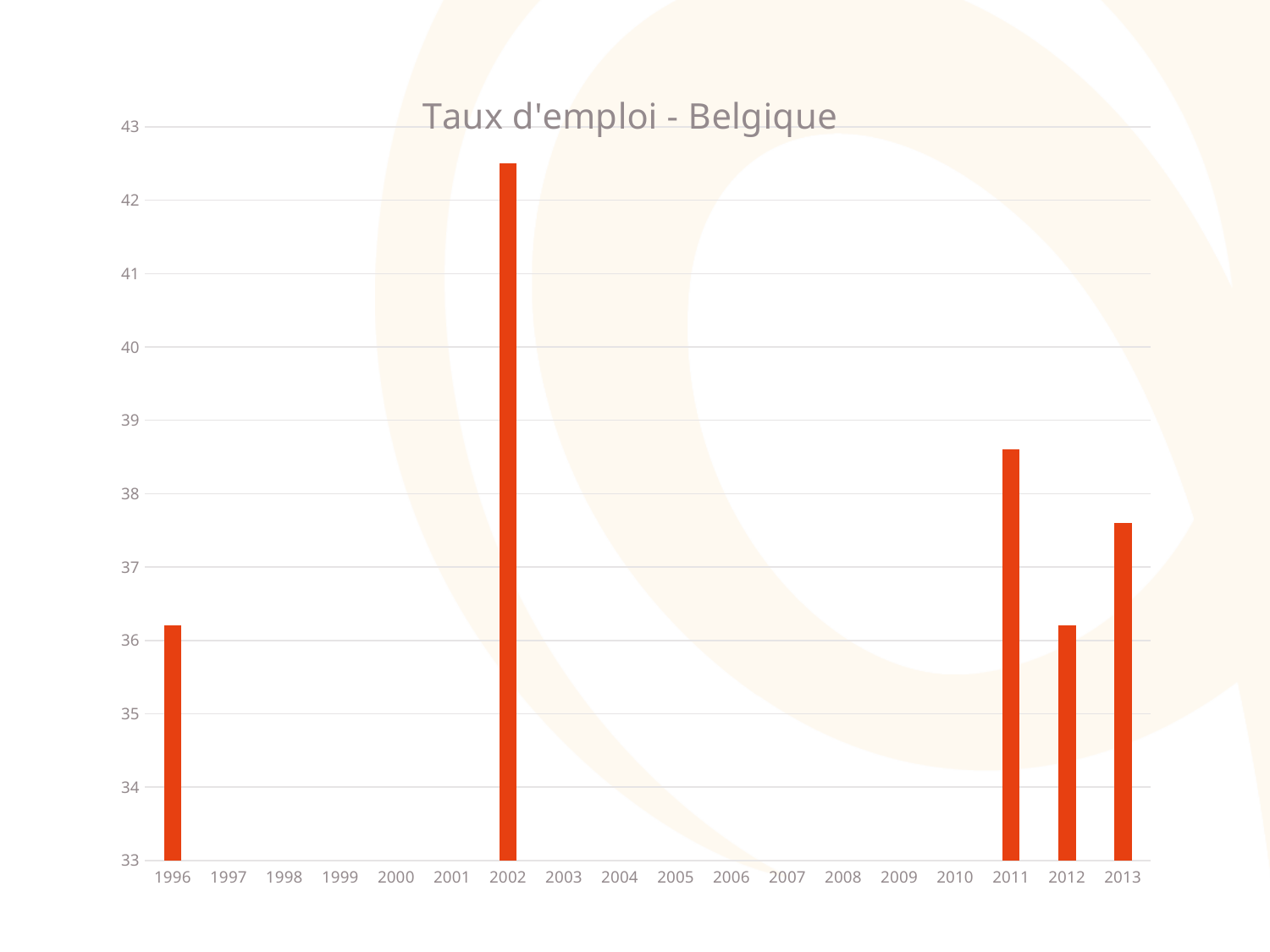
Is the value for 2002 greater or less than 42? greater How many years have a bar plotted in the chart? 5 Is the value for 2011 greater or less than 38? greater Is the value for 2012 greater or less than 37? less Which is larger, the value for 2002 or the value for 2011? 2002 Which is larger, the value for 2011 or the value for 2013? 2011 What kind of chart is shown on the slide? bar chart What is the title of the chart? Taux d'emploi - Belgique How many years are labelled along the x axis? 18 Which year has the highest value in the chart? 2002